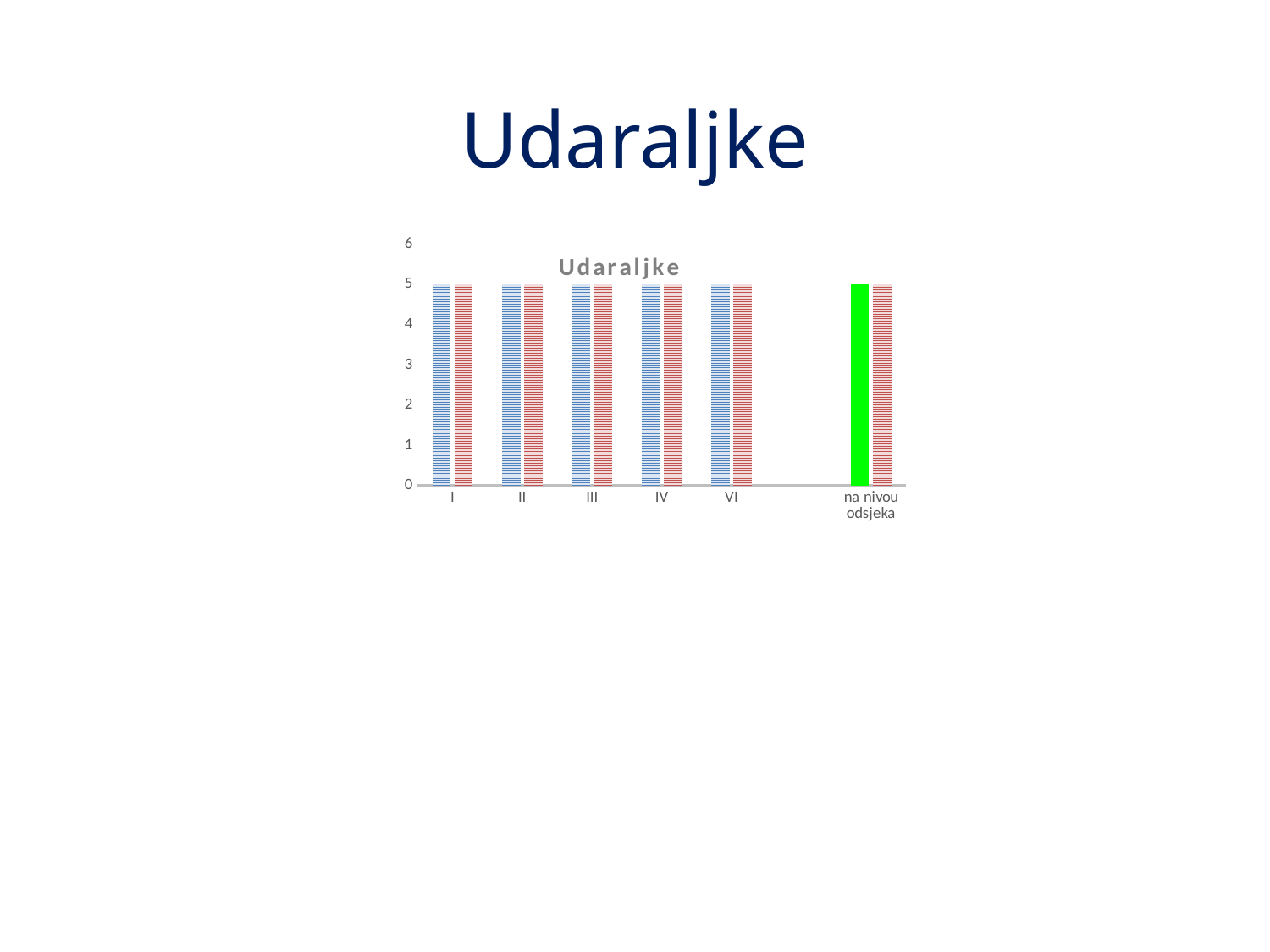
What value does the green bar for 'na nivou odsjeka' reach? 5 What is the highest value shown on the y axis? 6 Is the value for category VI greater or less than 4? greater What kind of chart is shown on the slide? bar chart What value does the red bar for category III reach? 5 What value does the blue bar for category I reach? 5 What is the label of the last category on the x axis? na nivou odsjeka How many categories are shown on the x axis of the chart? 6 What is the difference between the blue bar for category IV and the red bar for category IV? 0 What is the title of the chart? Udaraljke Is the value for category II greater or less than 6? less Do the bar values rise, fall, or stay the same across the categories from I to VI? stay the same